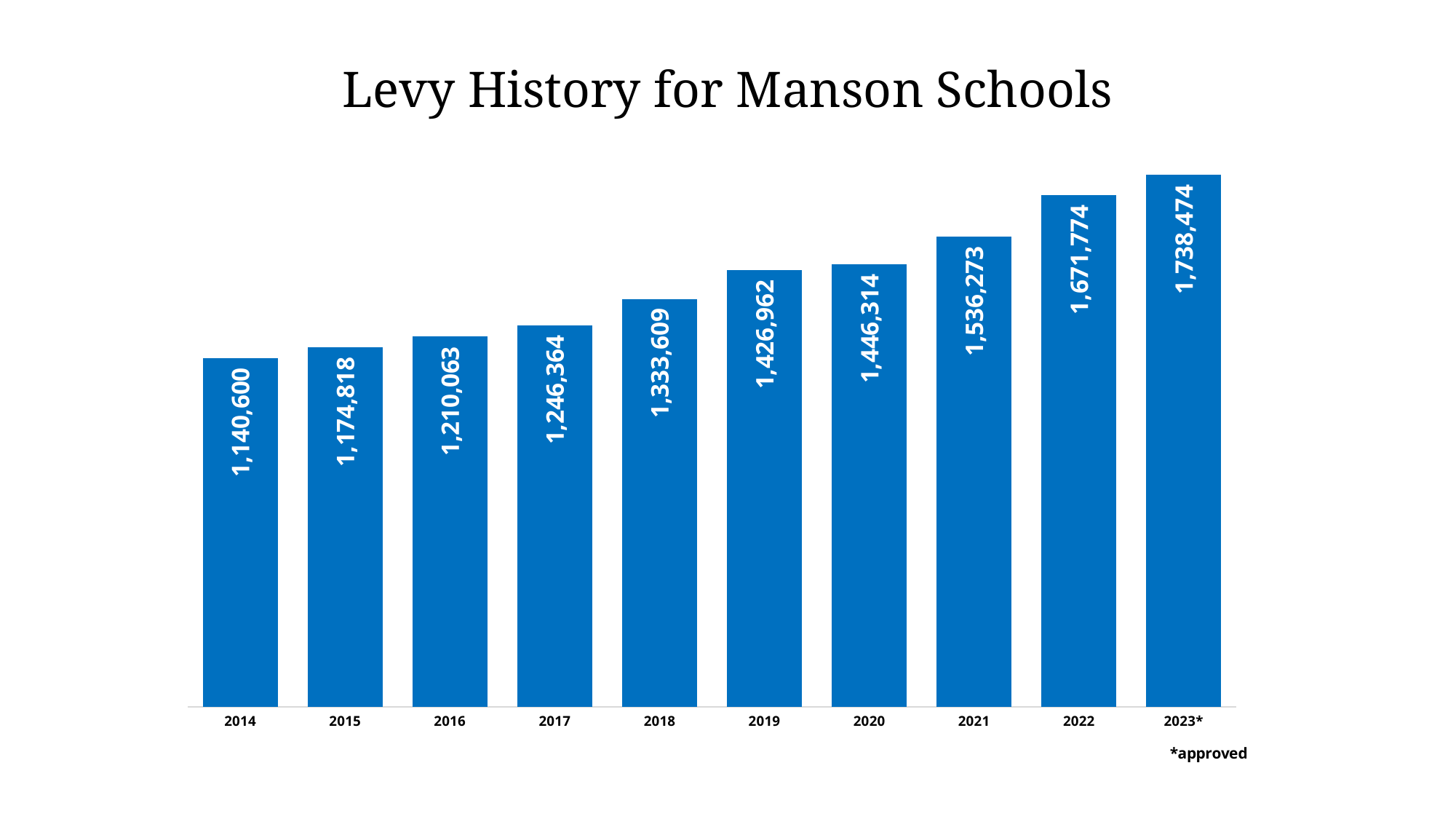
What is the levy value for 2018? 1,333,609 Which year has the lowest levy value? 2014 Which is larger, the levy value for 2019 or for 2020? 2020 Which year has the highest levy value? 2023* Do the levy values rise or fall from 2014 to 2023*? Rise What is the difference between the levy values for 2023* and 2014? 597,874 What kind of chart is shown on the slide? Bar chart How many years are shown on the chart? 10 What is the levy value for 2014? 1,140,600 What is the difference between the levy values for 2022 and 2021? 135,501 What is the levy value for 2021? 1,536,273 What is the title of the chart? Levy History for Manson Schools